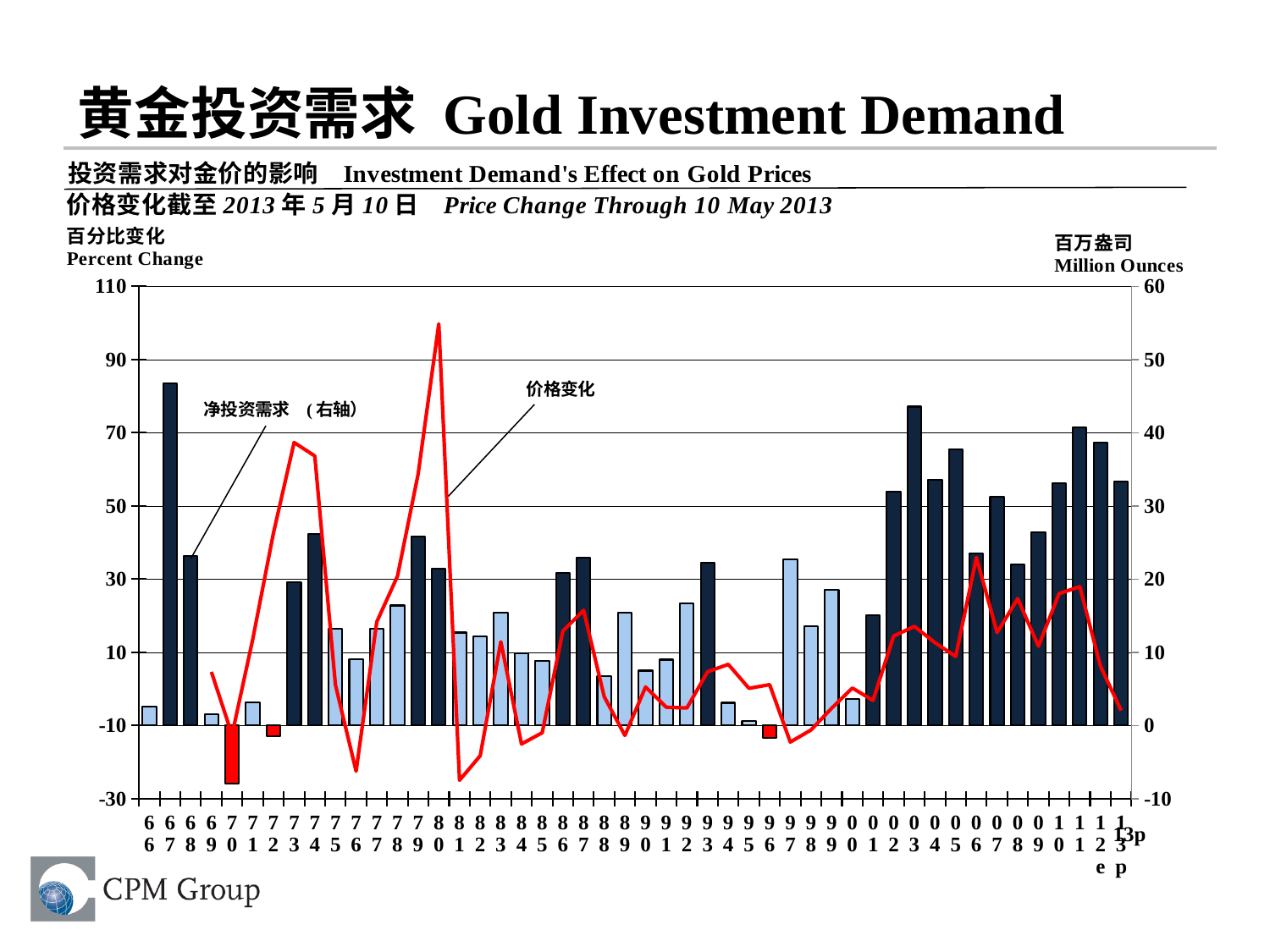
Is the net investment demand for 1967 greater or less than 40 million ounces? greater Which year has the lowest net investment demand bar? 1970 What kind of chart is shown on the slide? A combination bar and line chart Which year has the highest net investment demand bar? 1967 In which year does the price change line reach its highest point? 1980 Do the net investment demand bars rise or fall from 2001 to 2003? rise Which is larger, the price change in 1980 or the price change in 1973? 1980 Is the price change for 1980 greater or less than 90%? greater Is the price change for 1976 greater or less than -10%? less What unit is shown on the right-hand axis? Million Ounces Which is larger, the net investment demand bar for 2003 or for 2004? 2003